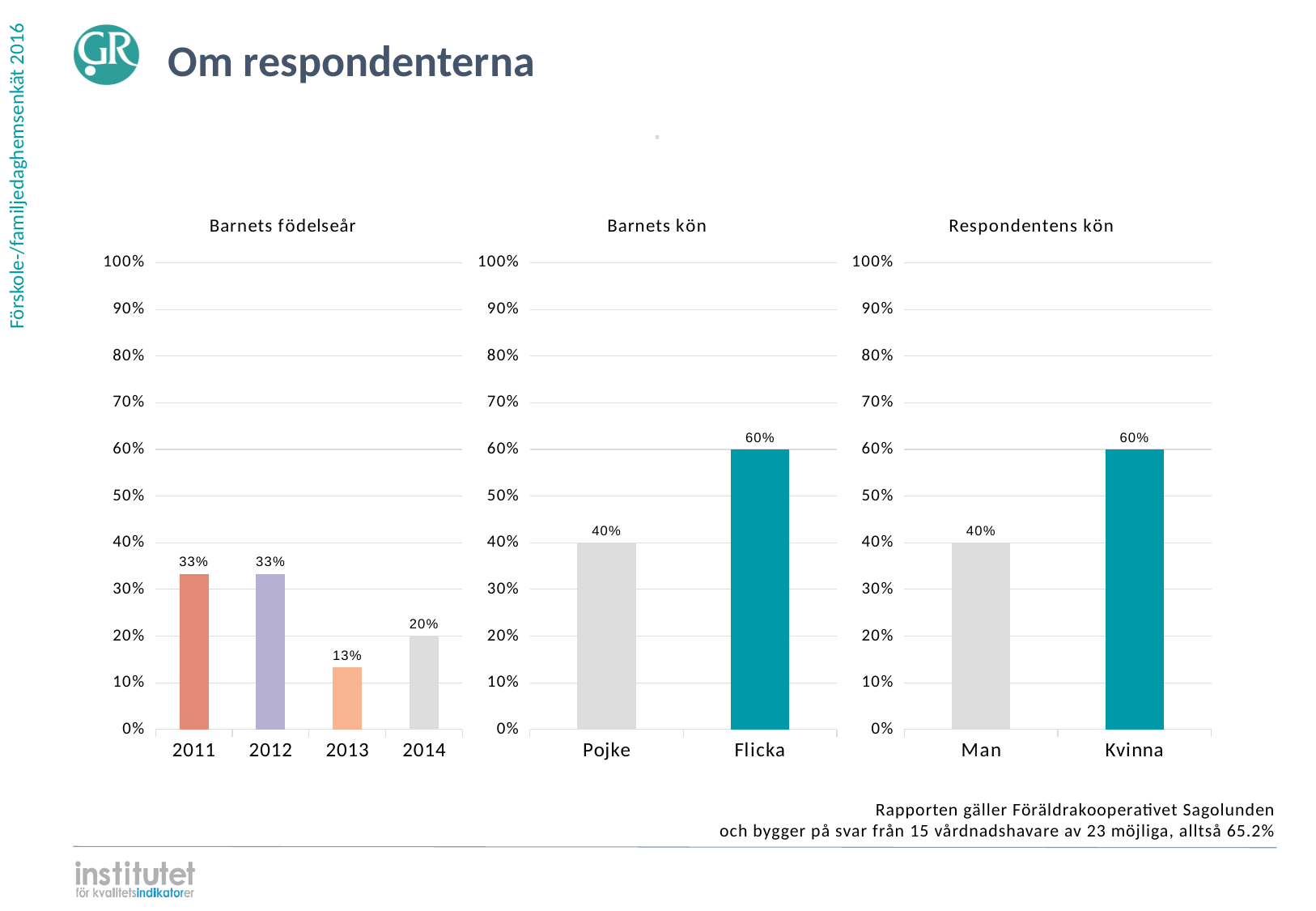
In the 'Barnets kön' chart, what is the difference between the values for Flicka and Pojke? 20% In the 'Barnets födelseår' chart, which year has the lowest value? 2013 In the 'Barnets kön' chart, which category has the higher value, Pojke or Flicka? Flicka In the 'Barnets födelseår' chart, how many years are shown on the x axis? 4 How many charts are shown on the slide? 3 What kind of chart is the 'Respondentens kön' chart? Bar chart In the 'Respondentens kön' chart, what is the value for Man? 40% In the 'Barnets födelseår' chart, what is the value for 2013? 13% In the 'Barnets födelseår' chart, what is the difference between the values for 2014 and 2013? 7% In the 'Barnets födelseår' chart, what is the value for 2014? 20% In the 'Respondentens kön' chart, which category has the highest value? Kvinna In the 'Barnets kön' chart, what is the value for Flicka? 60%